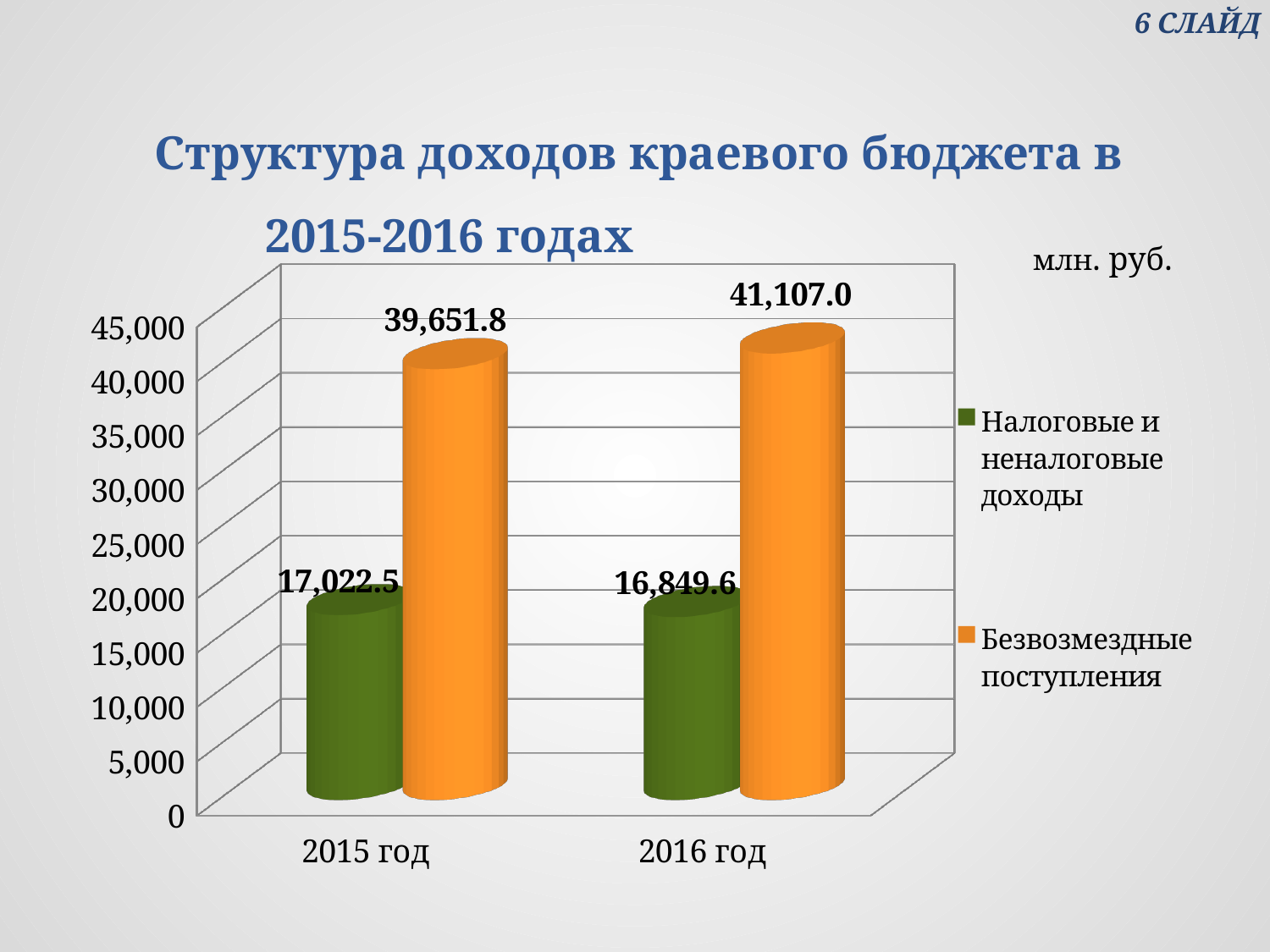
What kind of chart is shown on the slide? Bar chart What unit of measurement is indicated next to the chart? млн. руб. What is the value for Безвозмездные поступления in 2016 год? 41,107.0 What is the value for Налоговые и неналоговые доходы in 2016 год? 16,849.6 What is the value for Налоговые и неналоговые доходы in 2015 год? 17,022.5 What is the value for Безвозмездные поступления in 2015 год? 39,651.8 How many series does the legend list? 2 Which year has the lower value for Налоговые и неналоговые доходы? 2016 год By how much did Безвозмездные поступления increase from 2015 год to 2016 год? 1,455.2 Which year has the higher value for Безвозмездные поступления? 2016 год Which is larger in 2015 год: Налоговые и неналоговые доходы or Безвозмездные поступления? Безвозмездные поступления What is the difference between Безвозмездные поступления and Налоговые и неналоговые доходы in 2016 год? 24,257.4